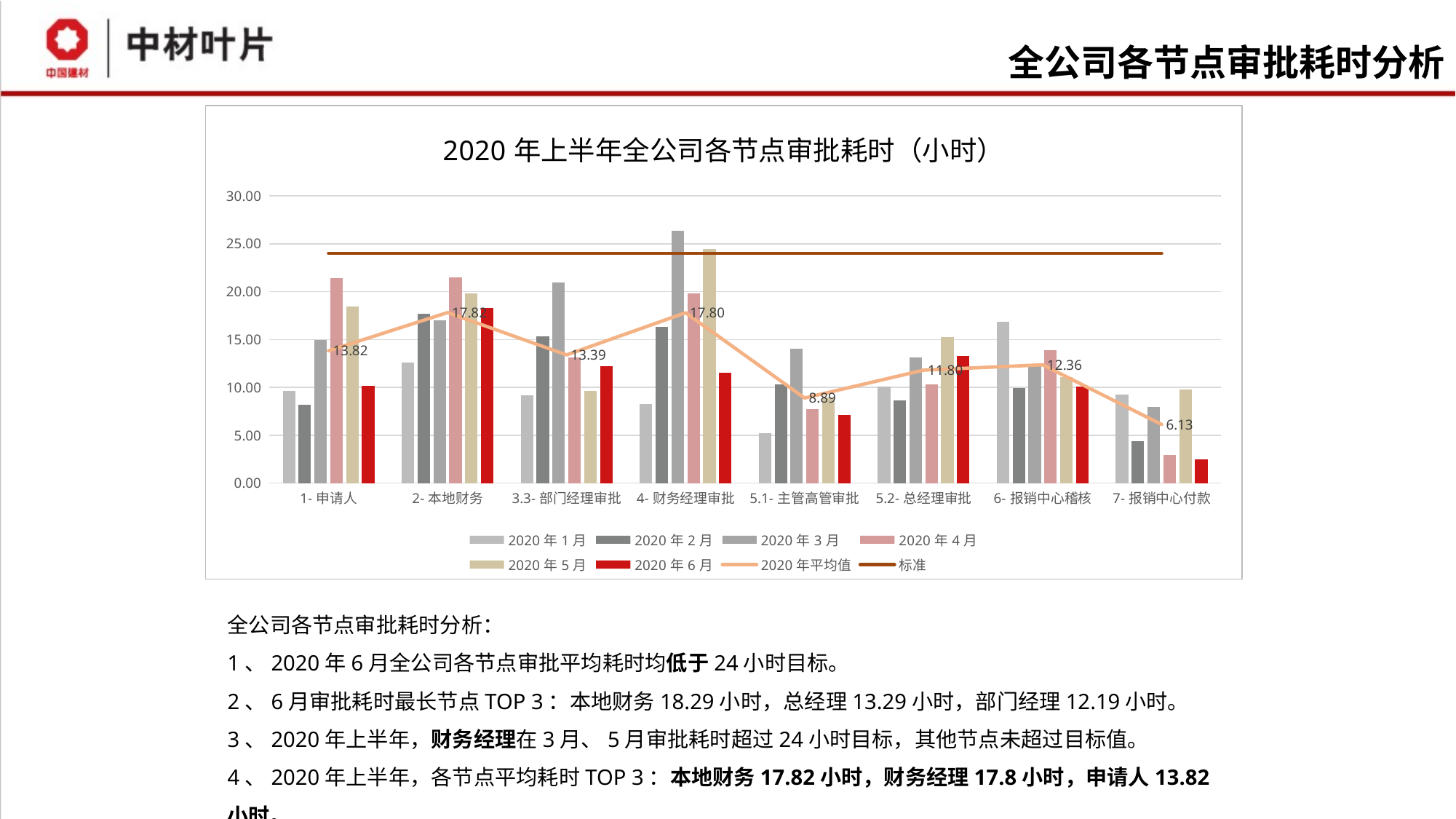
What is the difference between the 2020 年平均值 for 2- 本地财务 and 7- 报销中心付款? 11.69 What is the title of the chart? 2020 年上半年全公司各节点审批耗时（小时） Which category has the lowest 2020 年平均值? 7- 报销中心付款 Which has a higher 2020 年平均值, 1- 申请人 or 3.3- 部门经理审批? 1- 申请人 Is the 2020 年6月 value for 7- 报销中心付款 greater or less than 5.00? less What is the 2020 年平均值 for 1- 申请人? 13.82 Does the 2020 年平均值 line rise or fall from 6- 报销中心稽核 to 7- 报销中心付款? fall What is the 2020 年平均值 for 5.1- 主管高管审批? 8.89 What is the 2020 年平均值 for 7- 报销中心付款? 6.13 How many categories are shown on the x axis? 8 How many series does the legend list? 8 Is the 2020 年3月 value for 4- 财务经理审批 greater or less than 25.00? greater